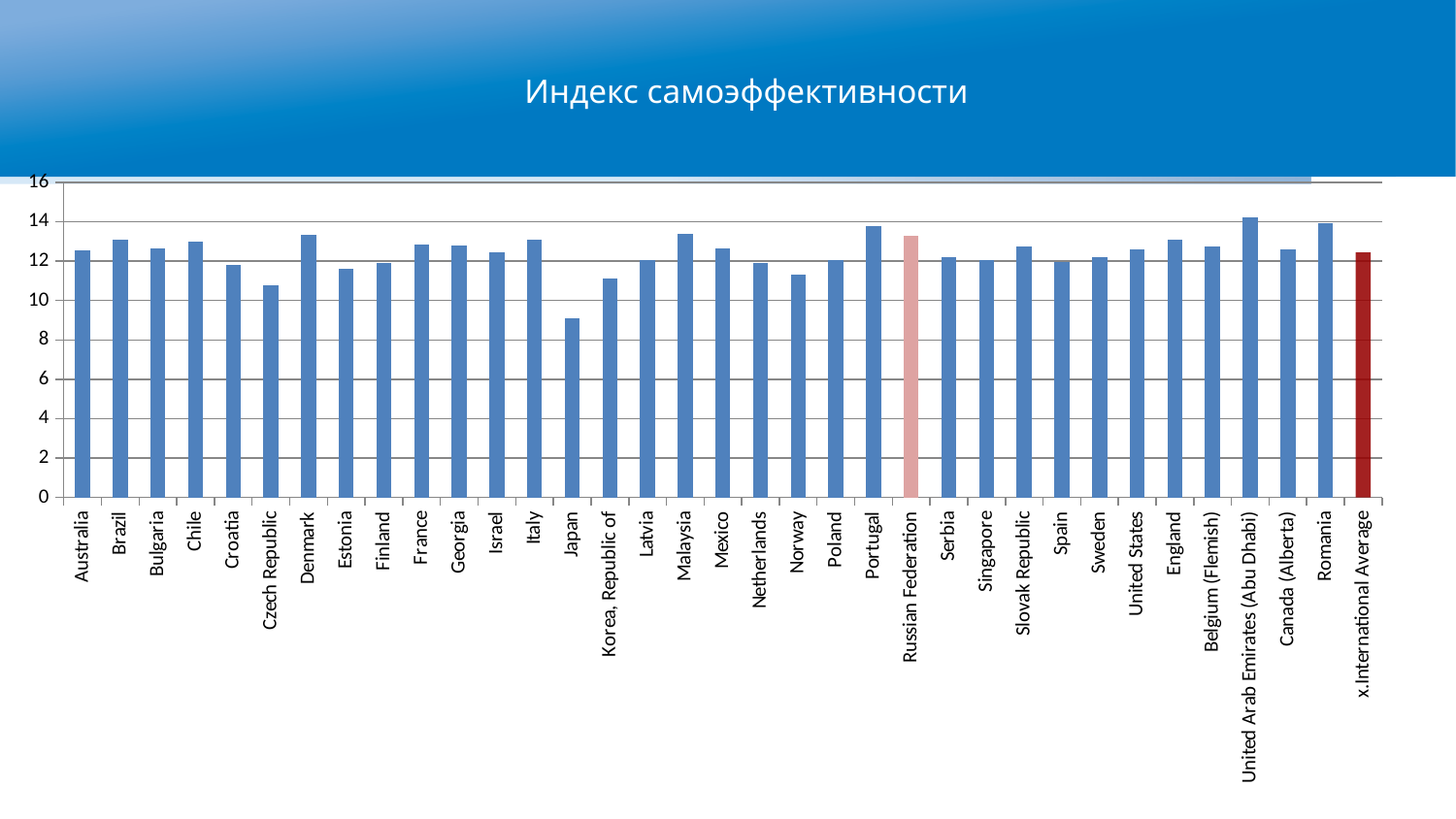
Is the value for Korea, Republic of greater or less than 12? less What is the title of the chart? Индекс самоэффективности Is the value for Norway greater or less than 12? less What kind of chart is shown on the slide? bar chart Is the value for Czech Republic greater or less than 10? greater Which category has the lowest value? Japan How many categories (bars) are shown on the x axis? 35 Which is larger, the value for Denmark or the value for Japan? Denmark Which is larger, the value for Portugal or the value for Norway? Portugal Which category's bar is drawn in dark red rather than blue? x.International Average